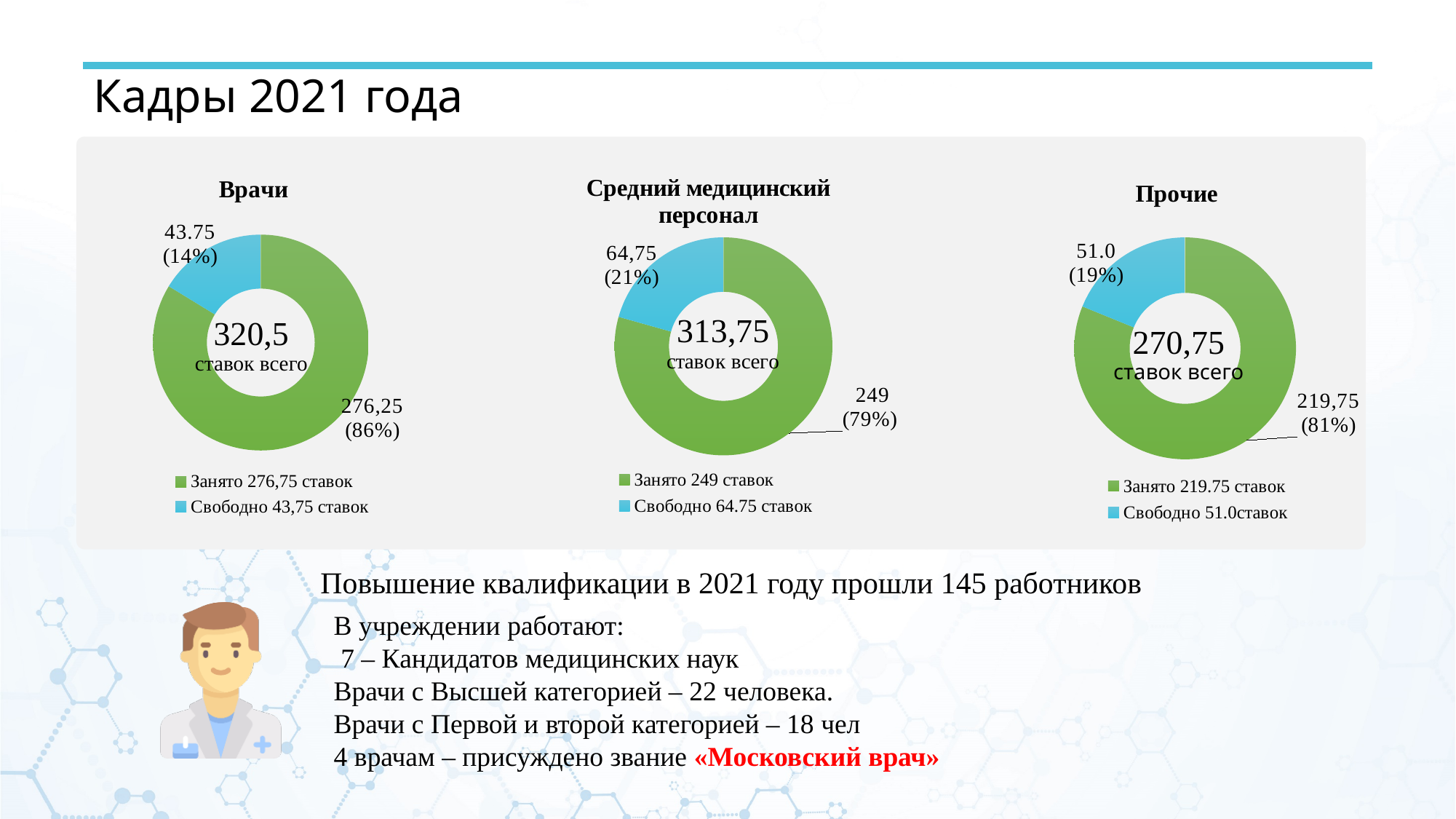
In the "Прочие" chart, what share of the total does the free (Свободно) slice represent? 19% In the "Врачи" chart, what share of the total does the free (Свободно) slice represent? 14% In the "Средний медицинский персонал" chart, what value is shown for the free (Свободно) slice? 64,75 How many entries does the legend of the "Средний медицинский персонал" chart list? 2 In the "Врачи" chart, what total number of positions is shown in the centre? 320,5 What kind of chart is used for the "Врачи" chart? Doughnut (pie) chart In the "Прочие" chart, which slice is larger, Занято or Свободно? Занято In the "Средний медицинский персонал" chart, what share of the total does the occupied (Занято) slice represent? 79% Which colour represents the free (Свободно) positions in the three charts? Blue In the "Средний медицинский персонал" chart, what value is shown for the occupied (Занято) slice? 249 In the "Прочие" chart, what value is shown for the occupied (Занято) slice? 219,75 In the "Врачи" chart, what value is shown for the free (Свободно) slice? 43.75